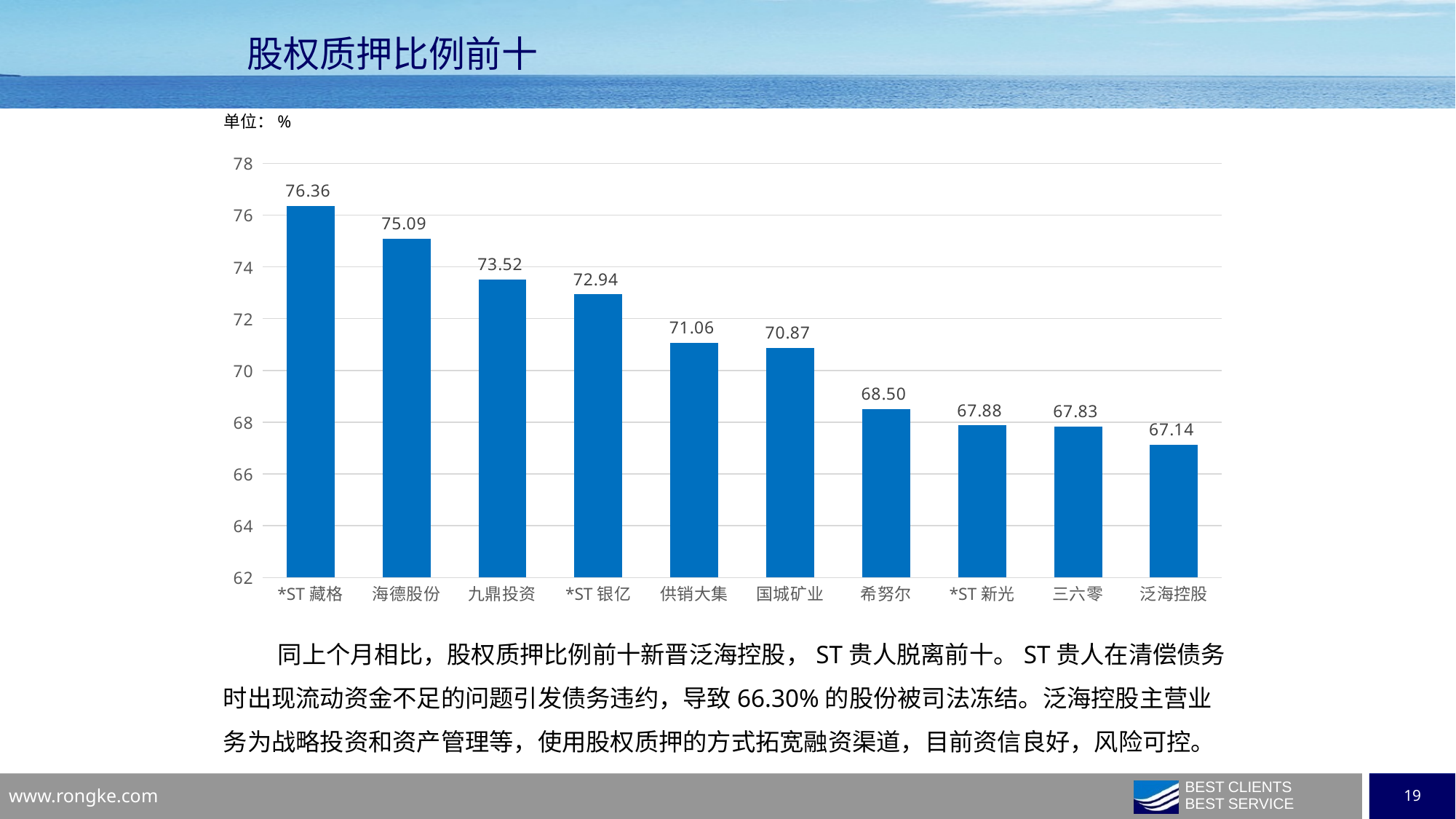
Which is larger, the value for 国城矿业 or the value for 希努尔? 国城矿业 What kind of chart is shown on the slide? Bar chart What is the value for 供销大集? 71.06 Is the value for *ST 银亿 greater or less than 72? greater What is the difference between the values for *ST 藏格 and 泛海控股? 9.22 What is the difference between the values for 海德股份 and 九鼎投资? 1.57 How many categories are shown in the chart? 10 What is the value for *ST 藏格? 76.36 Which category has the highest value? *ST 藏格 What is the value for 海德股份? 75.09 Which category has the lowest value? 泛海控股 What is the value for 泛海控股? 67.14